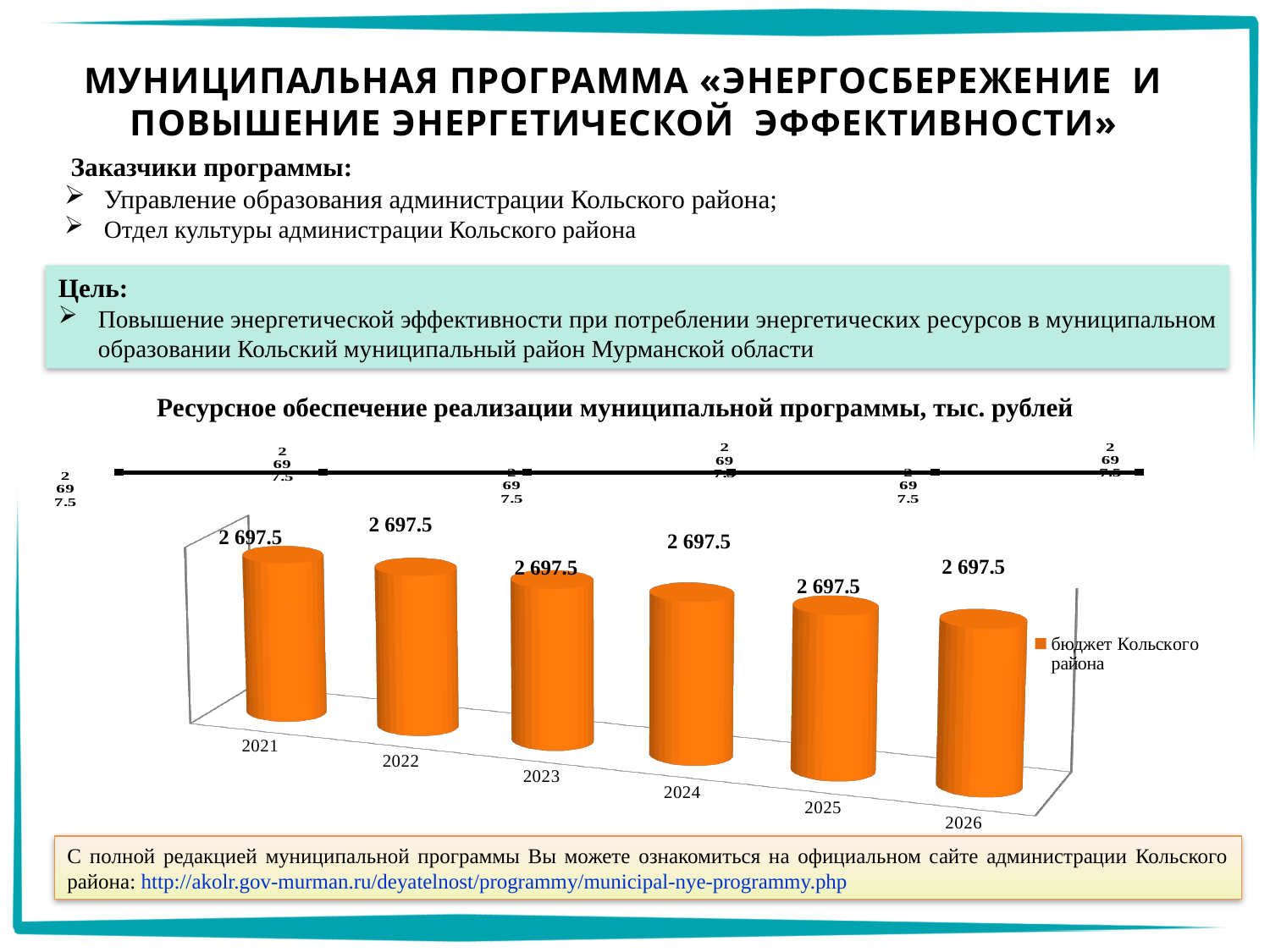
Is the value for 2023 larger than, smaller than, or equal to the value for 2026? Equal What is the value for 2024 in the chart? 2 697.5 How many years (categories) are shown on the x axis of the chart? 6 Do the values rise, fall or stay the same from 2021 to 2026? Stay the same What is the value for 2026 in the chart? 2 697.5 What series name is shown in the chart legend? бюджет Кольского района How many series does the chart legend list? 1 Which year is the first category on the x axis of the chart? 2021 What is the difference between the values for 2022 and 2025? 0 What is the title of the chart? Ресурсное обеспечение реализации муниципальной программы, тыс. рублей What kind of chart is shown on the slide? Bar chart What is the value for 2021 in the chart 'Ресурсное обеспечение реализации муниципальной программы, тыс. рублей'? 2 697.5